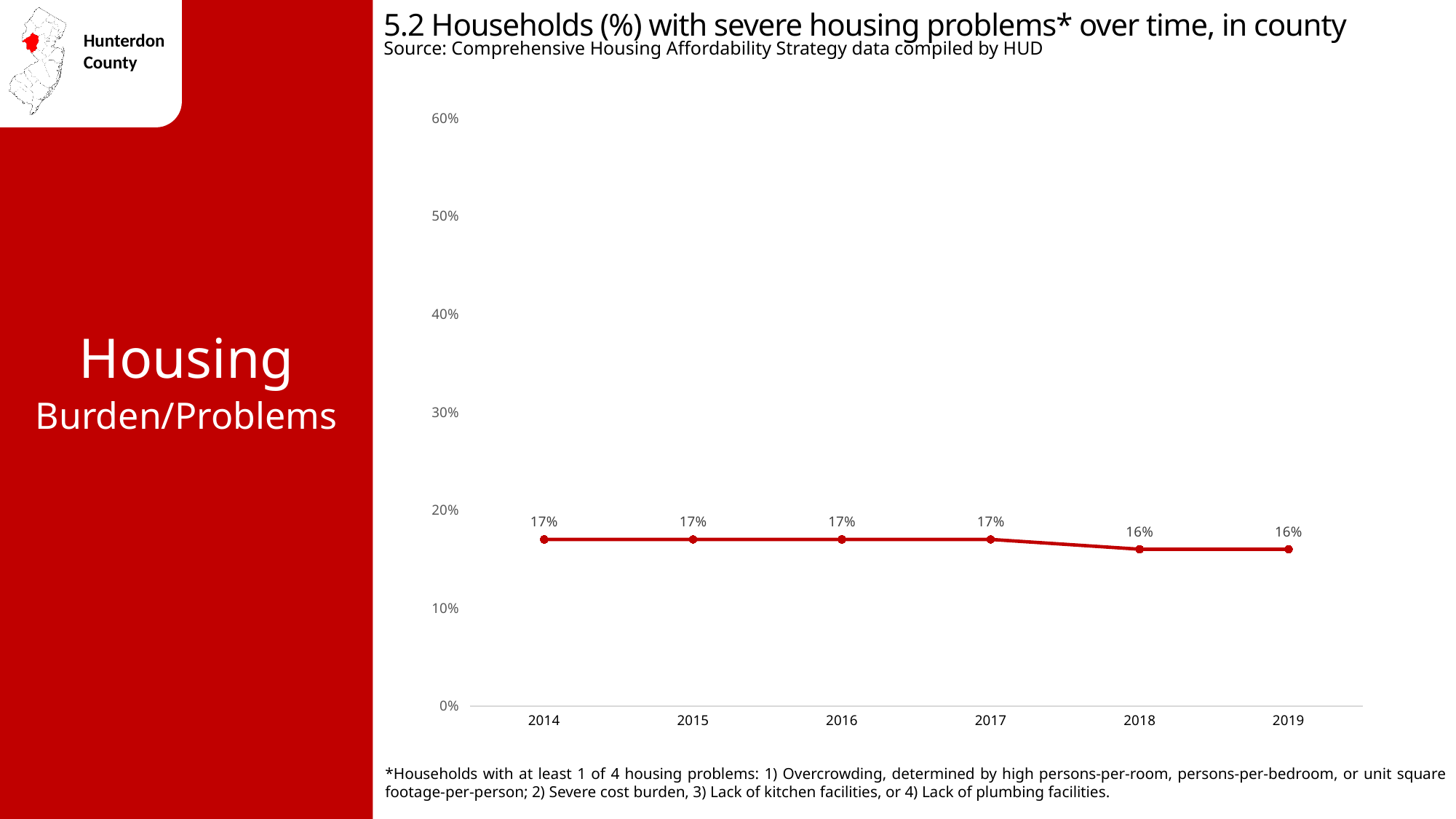
What percentage of households had severe housing problems in 2019? 16% Do the values rise or fall from 2014 to 2019? fall How many years are plotted on the chart? 6 Is the value for 2017 greater or less than 20%? less Which is larger, the value for 2015 or the value for 2019? 2015 What is the source of the data shown in the chart? Comprehensive Housing Affordability Strategy data compiled by HUD What percentage of households had severe housing problems in 2018? 16% What is the difference between the 2017 value and the 2018 value? 1% What percentage of households had severe housing problems in 2014? 17% What is the title of the chart? 5.2 Households (%) with severe housing problems* over time, in county What kind of chart is shown on the slide? line chart What is the value shown for 2016? 17%